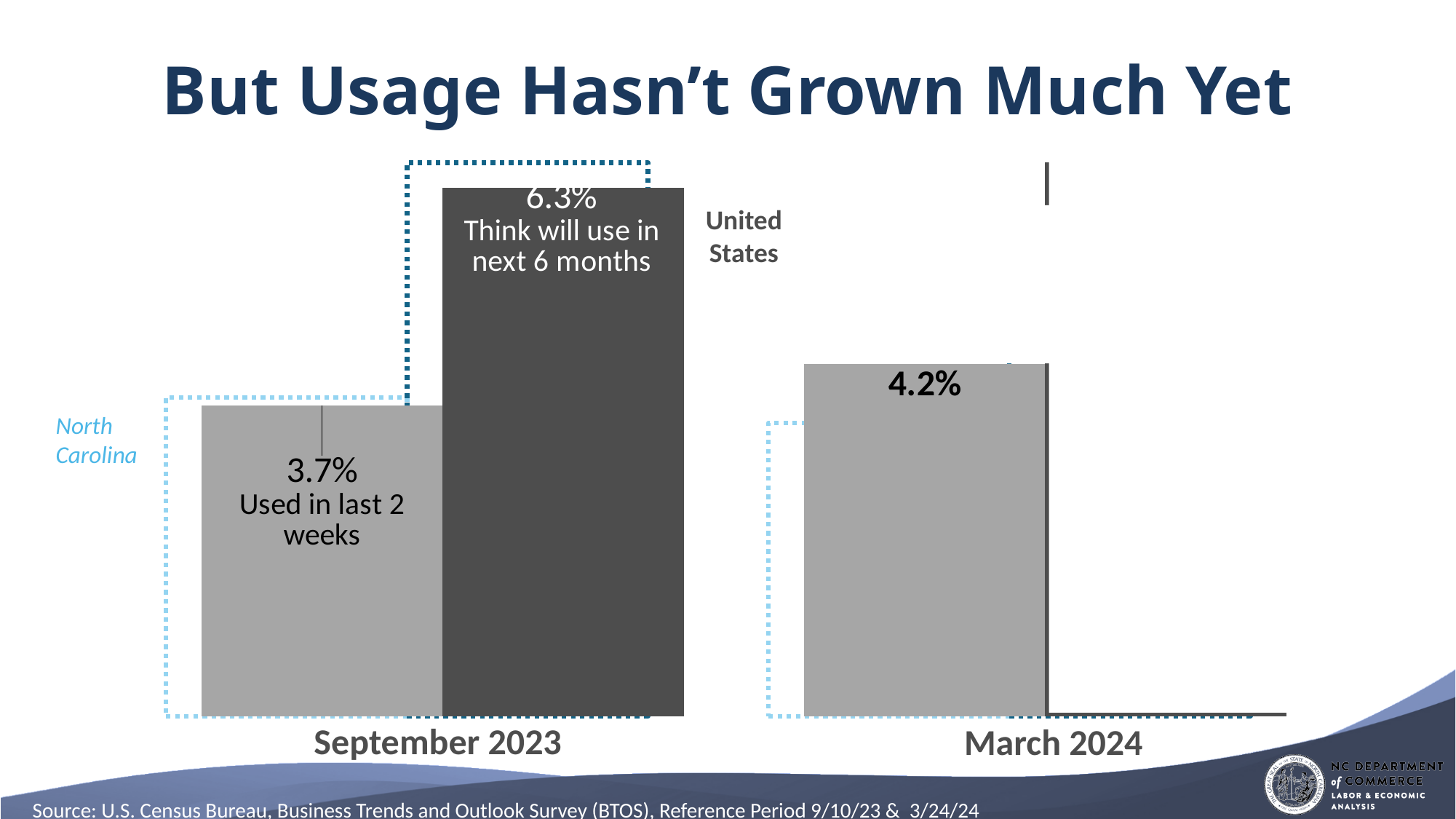
How many time periods are shown on the x axis? 2 What is the value for "Think will use in next 6 months" in September 2023? 6.3% What is the value for "Used in last 2 weeks" in September 2023? 3.7% What type of chart is shown on the slide? bar chart By how much did the "Used in last 2 weeks" value change from September 2023 to March 2024? 0.5% Which is larger: the "Used in last 2 weeks" value in September 2023 or in March 2024? March 2024 What is the value for "Used in last 2 weeks" in March 2024? 4.2% What is the difference between the "Think will use in next 6 months" value and the "Used in last 2 weeks" value in September 2023? 2.6% What is the title of the chart? But Usage Hasn't Grown Much Yet Did the "Used in last 2 weeks" value rise or fall from September 2023 to March 2024? rise Which labeled bar has the lowest value? Used in last 2 weeks (September 2023) Which labeled bar has the highest value? Think will use in next 6 months (September 2023)